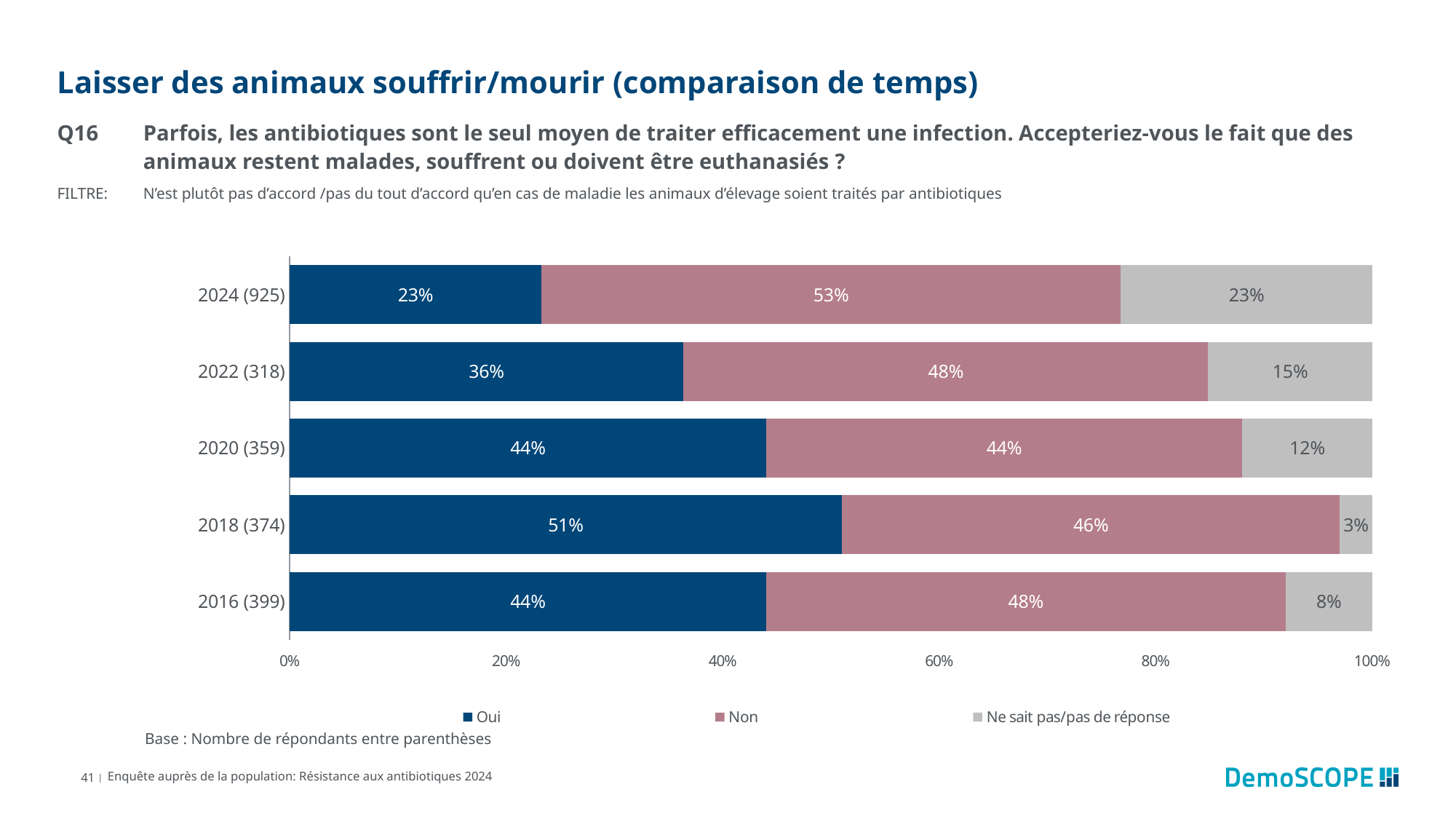
What kind of chart is shown on the slide? Stacked bar chart Which year has the lowest 'Oui' value? 2024 (925) How many series does the legend list? 3 What is the total of the 'Oui' and 'Non' segments for 2016 (399)? 92% How many year categories are shown on the chart? 5 What is the 'Ne sait pas/pas de réponse' value for 2018 (374)? 3% Is the 'Non' value larger for 2024 (925) or for 2020 (359)? 2024 (925) Which year has the highest 'Ne sait pas/pas de réponse' value? 2024 (925) What is the 'Oui' value for 2024 (925)? 23% What is the difference between the 'Oui' values for 2018 (374) and 2024 (925)? 28 percentage points What is the 'Non' value for 2022 (318)? 48% Which year has the highest 'Oui' value? 2018 (374)